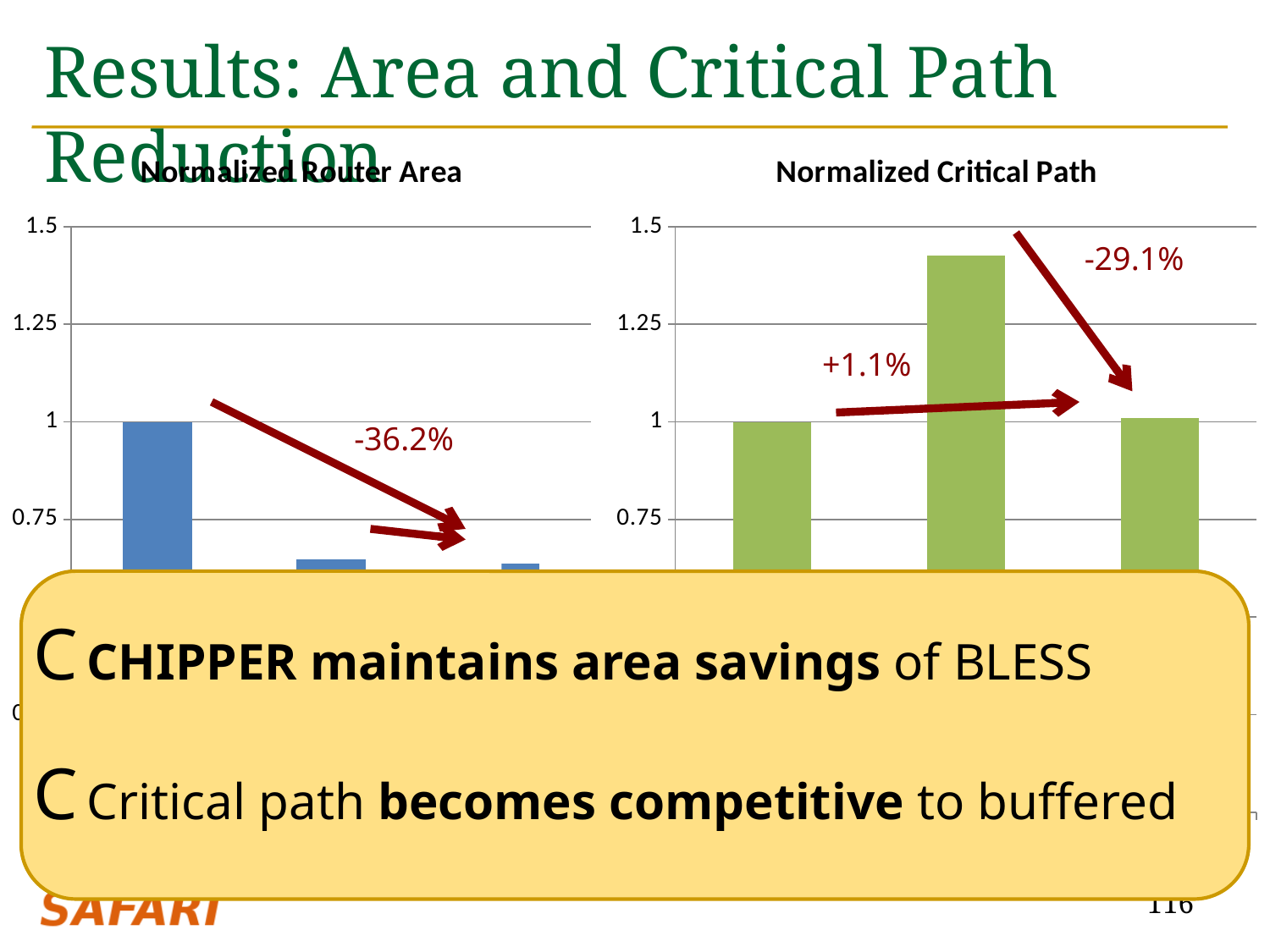
In the Normalized Router Area chart, is the value of the second bar greater or less than 0.75? less What kind of chart is the Normalized Router Area chart? bar chart In the Normalized Router Area chart, what is the value of the first (leftmost) bar? 1 In the Normalized Critical Path chart, what is the value of the first (leftmost) bar? 1 In the Normalized Critical Path chart, which bar is the highest? the second (middle) bar In the Normalized Router Area chart, which bar is the highest? the first (leftmost) bar How many bars are plotted in the Normalized Critical Path chart? 3 In the Normalized Critical Path chart, is the value of the second (middle) bar greater or less than 1.25? greater What percentage change is annotated on the Normalized Router Area chart? -36.2% What two percentage changes are annotated on the Normalized Critical Path chart? +1.1% and -29.1% In the Normalized Router Area chart, do the bar values rise or fall from left to right? fall In the Normalized Critical Path chart, which is larger: the first bar or the second bar? the second bar